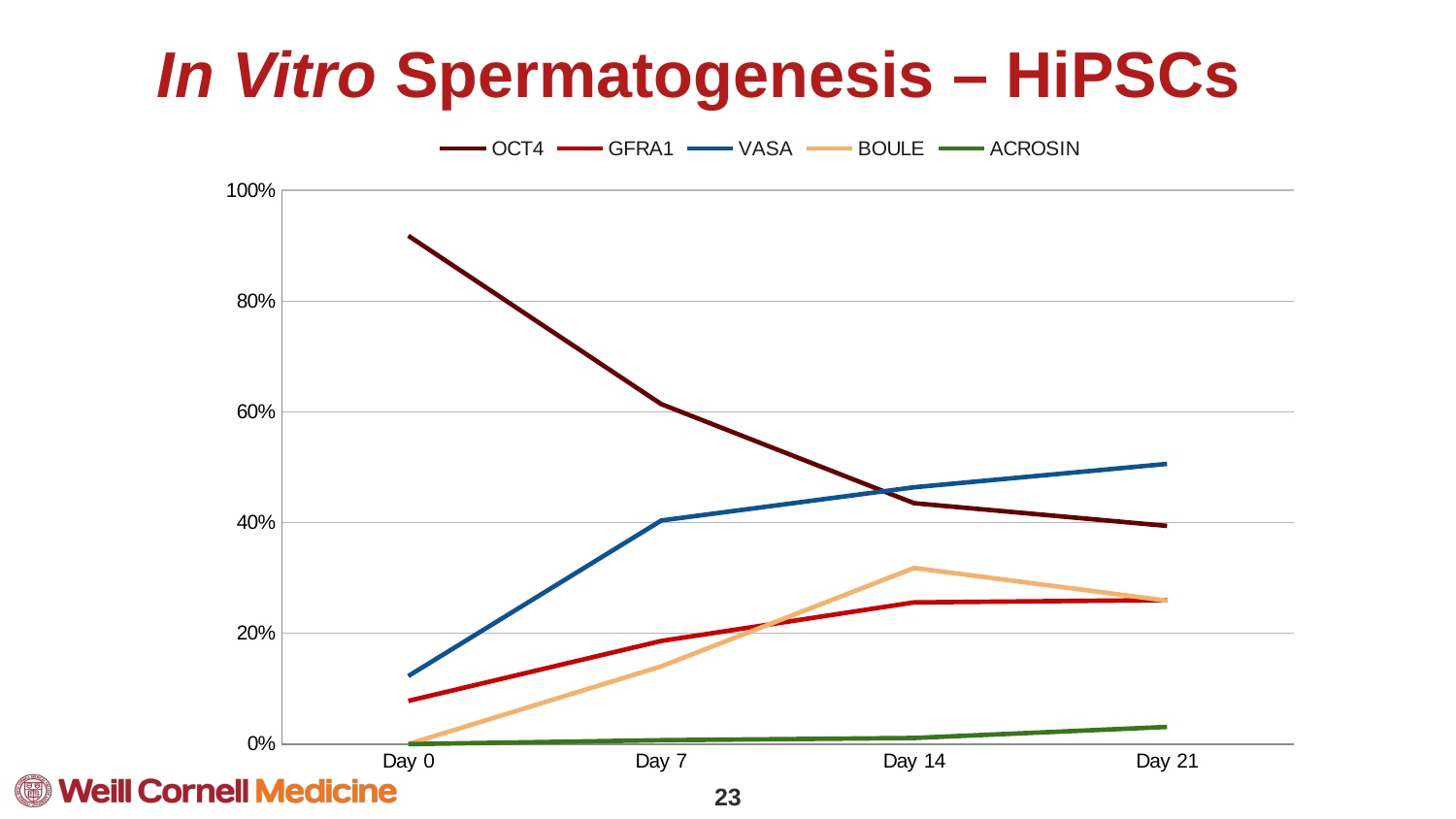
Is the value for VASA at Day 21 greater or less than 40%? greater How many series does the legend list? 5 At Day 0, which is larger, OCT4 or VASA? OCT4 Which series has the highest value at Day 0? OCT4 Does the VASA line rise or fall from Day 0 to Day 21? rise Is the value for BOULE at Day 14 greater or less than 20%? greater Is the value for OCT4 at Day 0 greater or less than 80%? greater Which series has the lowest value at Day 21? ACROSIN Does the OCT4 line rise or fall from Day 0 to Day 21? fall How many time points are shown on the x axis? 4 At Day 21, which is larger, VASA or OCT4? VASA What kind of chart is shown on the slide? line chart